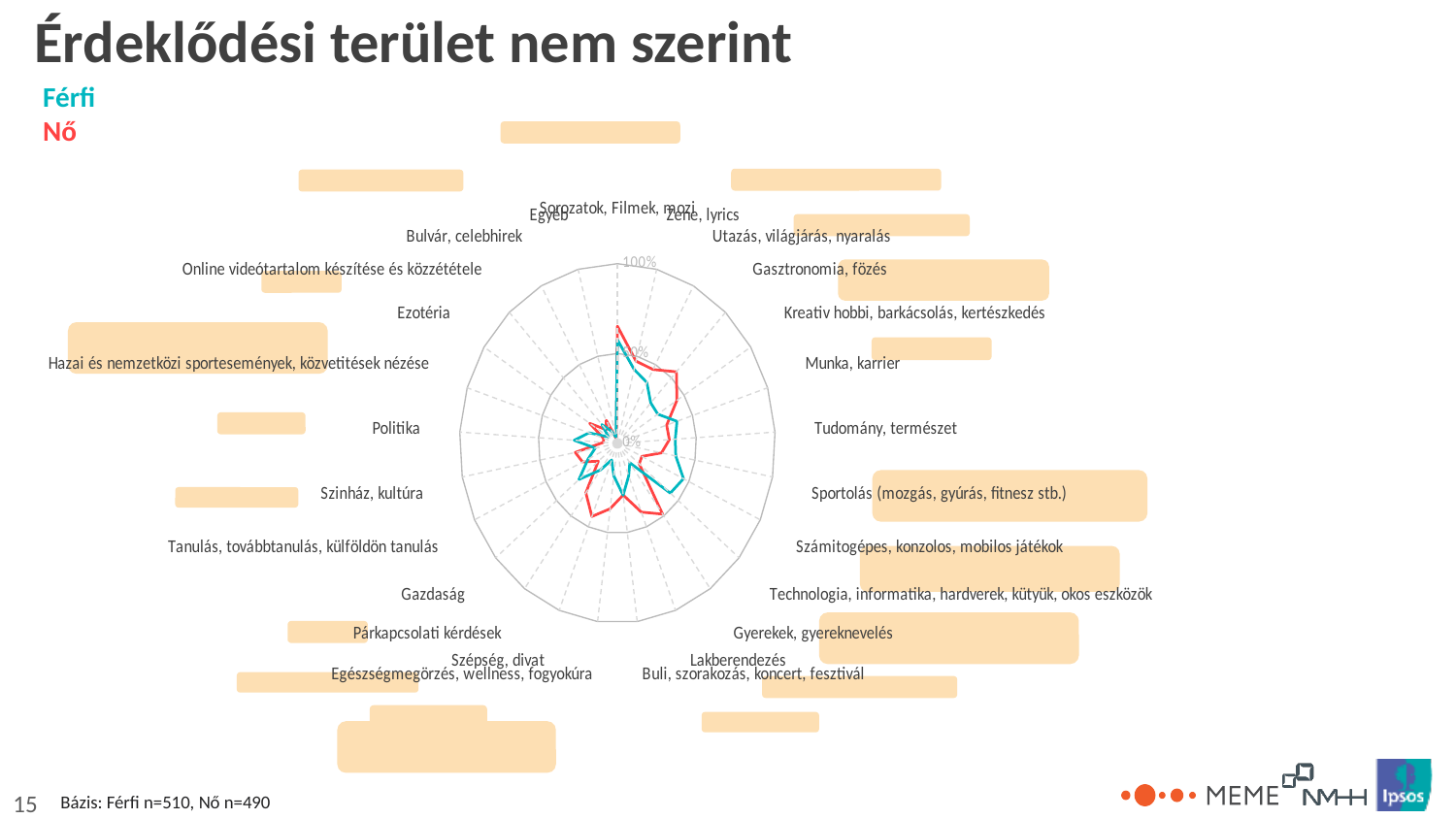
Which colour represents the Férfi series? teal For Gasztronómia, főzés, which series has the larger value, Férfi or Nő? Nő Which colour represents the Nő series? red Is the value for Egyéb for Férfi greater or less than 50%? less How many series does the legend list? 2 What kind of chart is shown on the slide? radar chart Is the value for Ezotéria for Nő greater or less than 50%? less What is the highest percentage tick shown on the radar chart's axis? 100% Is the value for Politika for Férfi greater or less than 50%? less For Hazai és nemzetközi sportesemények, közvetítések nézése, which series has the larger value, Férfi or Nő? Férfi